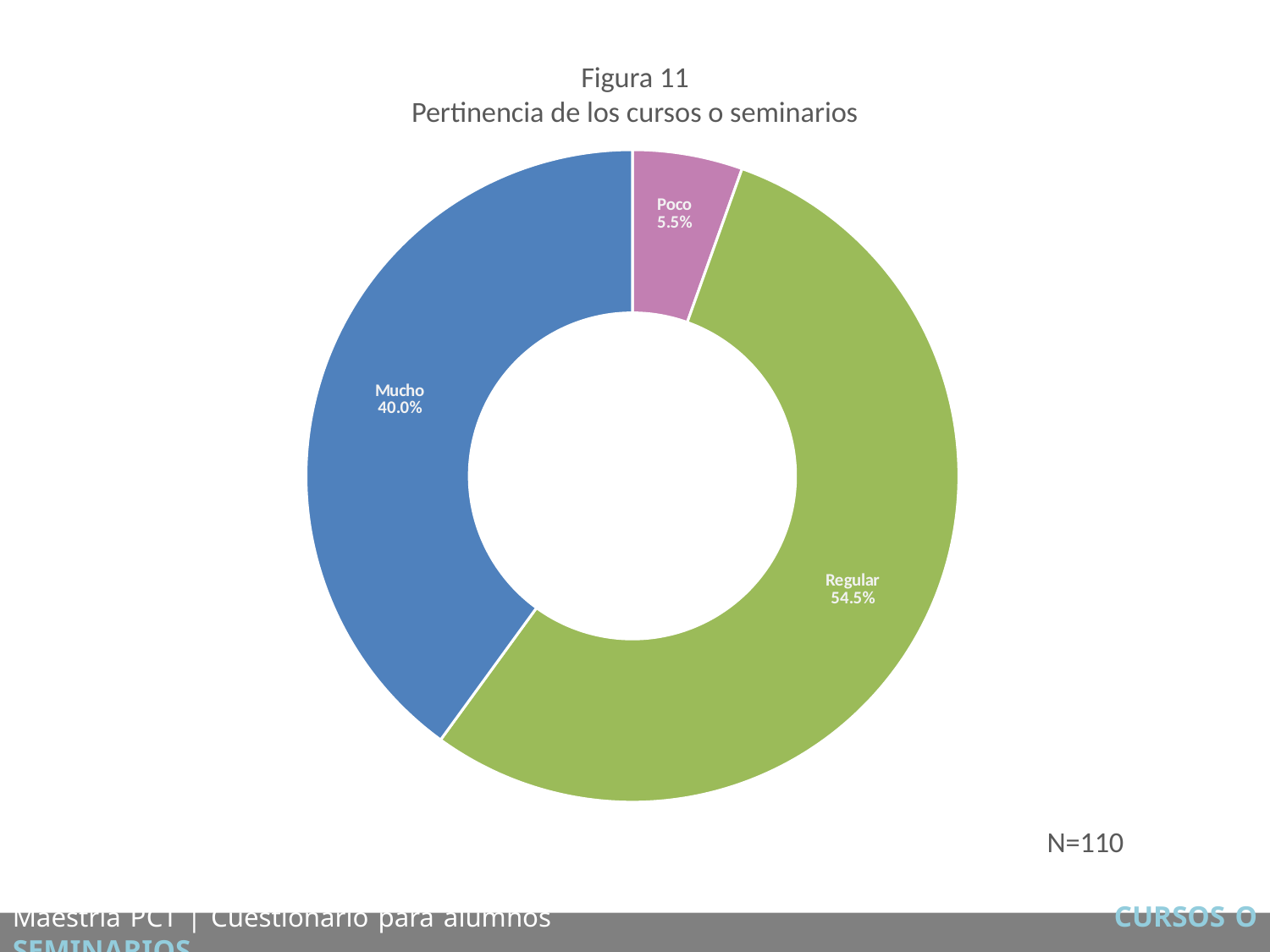
What percentage is shown for the "Mucho" slice? 40.0% What is the title of the chart? Figura 11 Pertinencia de los cursos o seminarios How many categories are shown in the chart? 3 What sample size (N) is stated on the slide? N=110 What is the difference in percentage points between "Regular" and "Mucho"? 14.5 What is the difference in percentage points between "Mucho" and "Poco"? 34.5 Which category has the smallest share of the chart? Poco What percentage is shown for the "Regular" slice? 54.5% What percentage is shown for the "Poco" slice? 5.5% What kind of chart is shown on the slide? Pie chart (doughnut) Which category has the largest share of the chart? Regular Which is larger, the share for "Mucho" or the share for "Poco"? Mucho